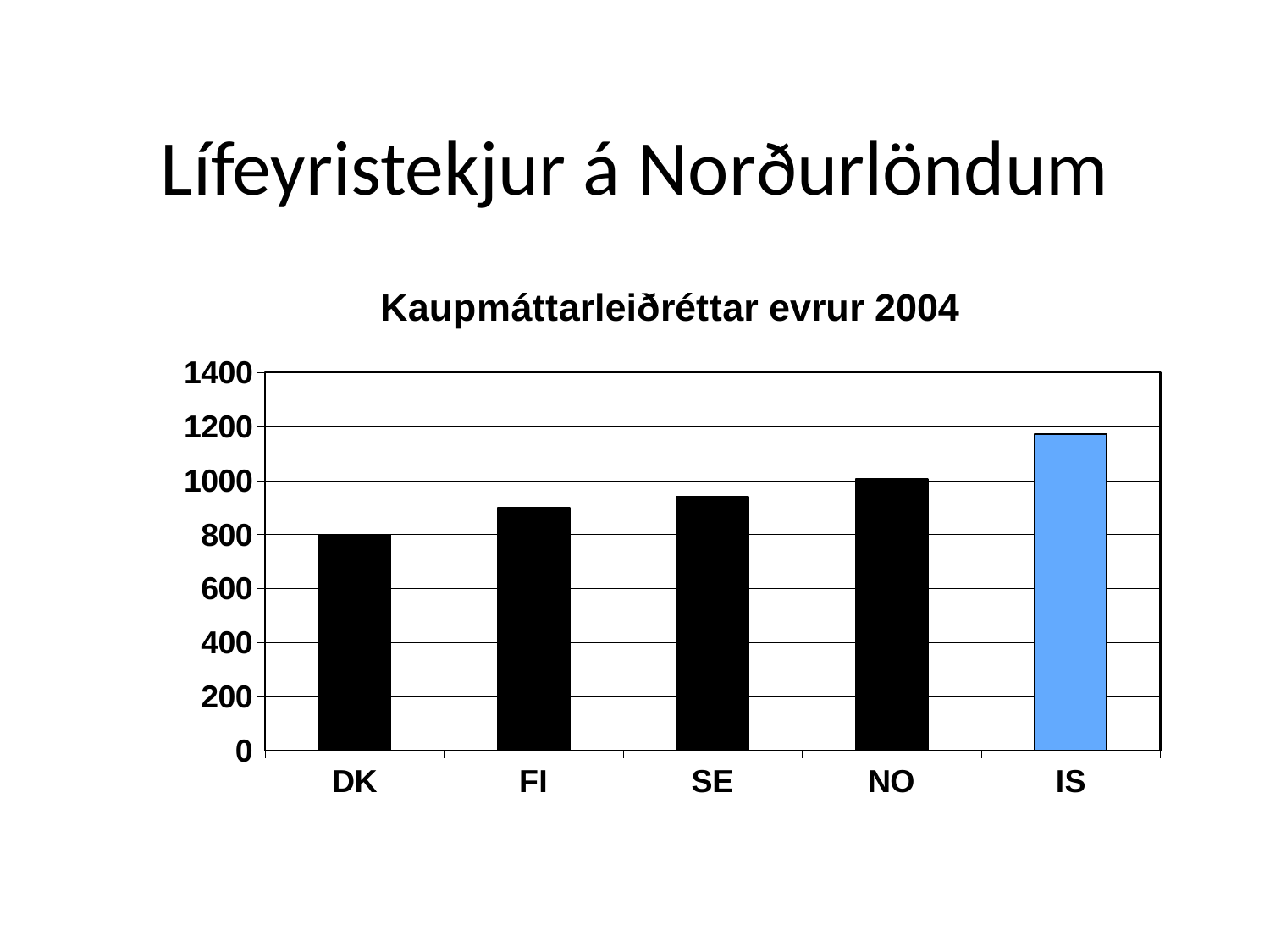
Do the values rise or fall from DK to IS along the x axis? rise How many countries are shown on the x axis of the chart? 5 Is the value for IS greater or less than 1000? greater Which country has the highest value in the chart? IS Is the value for FI greater or less than 1000? less Which has the larger value, DK or FI? FI What is the title of the chart? Kaupmáttarleiðréttar evrur 2004 Which country has the lowest value in the chart? DK What kind of chart is shown on the slide? bar chart Which country's bar is coloured blue instead of black? IS Which has the larger value, NO or SE? NO Is the value for IS greater or less than 1200? less